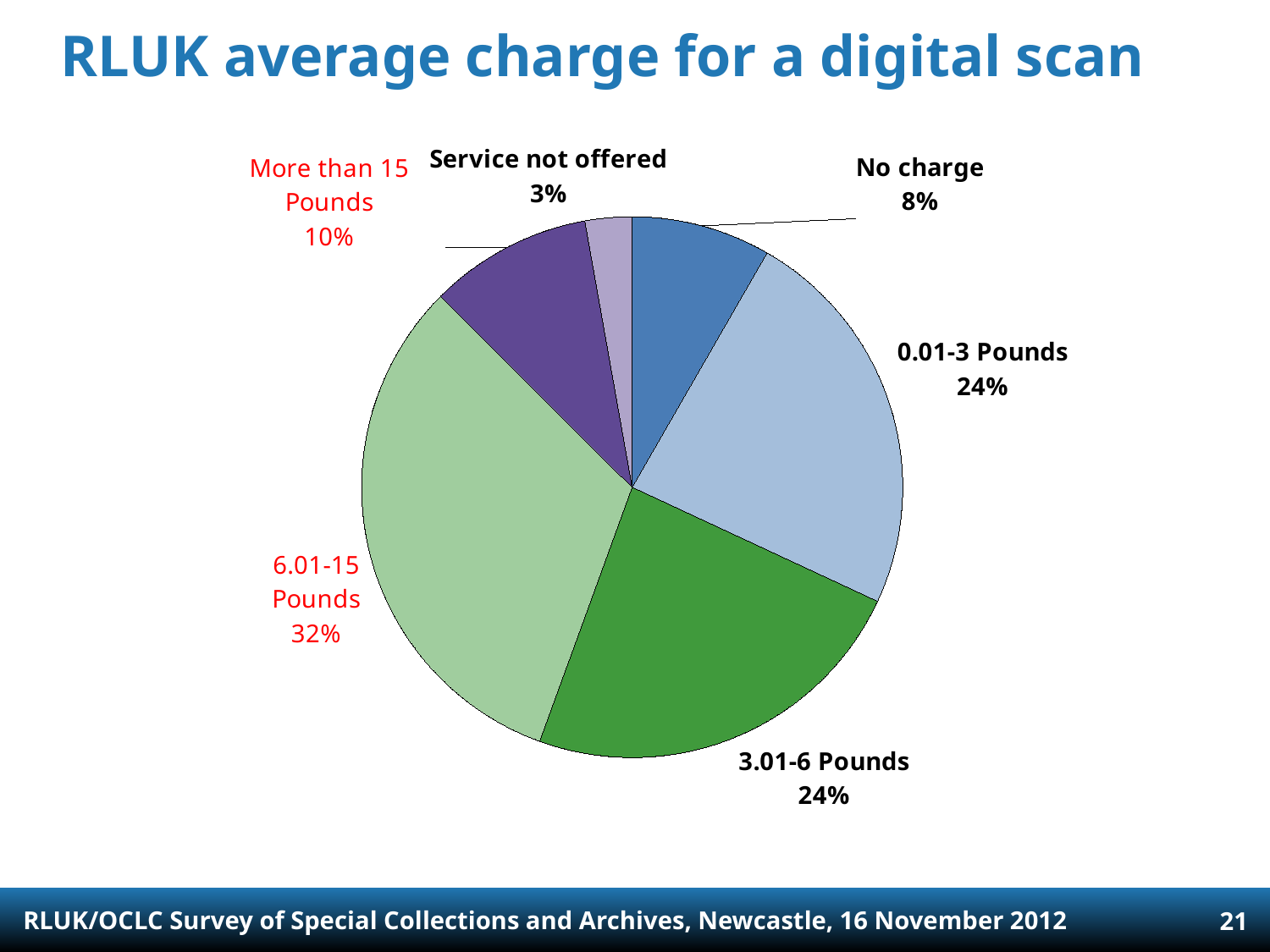
What percentage is shown for Service not offered? 3% What is the difference in percentage points between 6.01-15 Pounds and 3.01-6 Pounds? 8 Which category has the smallest slice of the pie? Service not offered How many categories are shown in the pie chart? 6 Which is larger, the share for No charge or the share for More than 15 Pounds? More than 15 Pounds What kind of chart is shown on the slide? pie chart What is the title of the chart? RLUK average charge for a digital scan What share of the pie is labelled 6.01-15 Pounds? 32% What percentage is shown for More than 15 Pounds? 10% Which category has the largest slice of the pie? 6.01-15 Pounds What percentage is shown for No charge? 8% What is the combined percentage of 0.01-3 Pounds and 3.01-6 Pounds? 48%